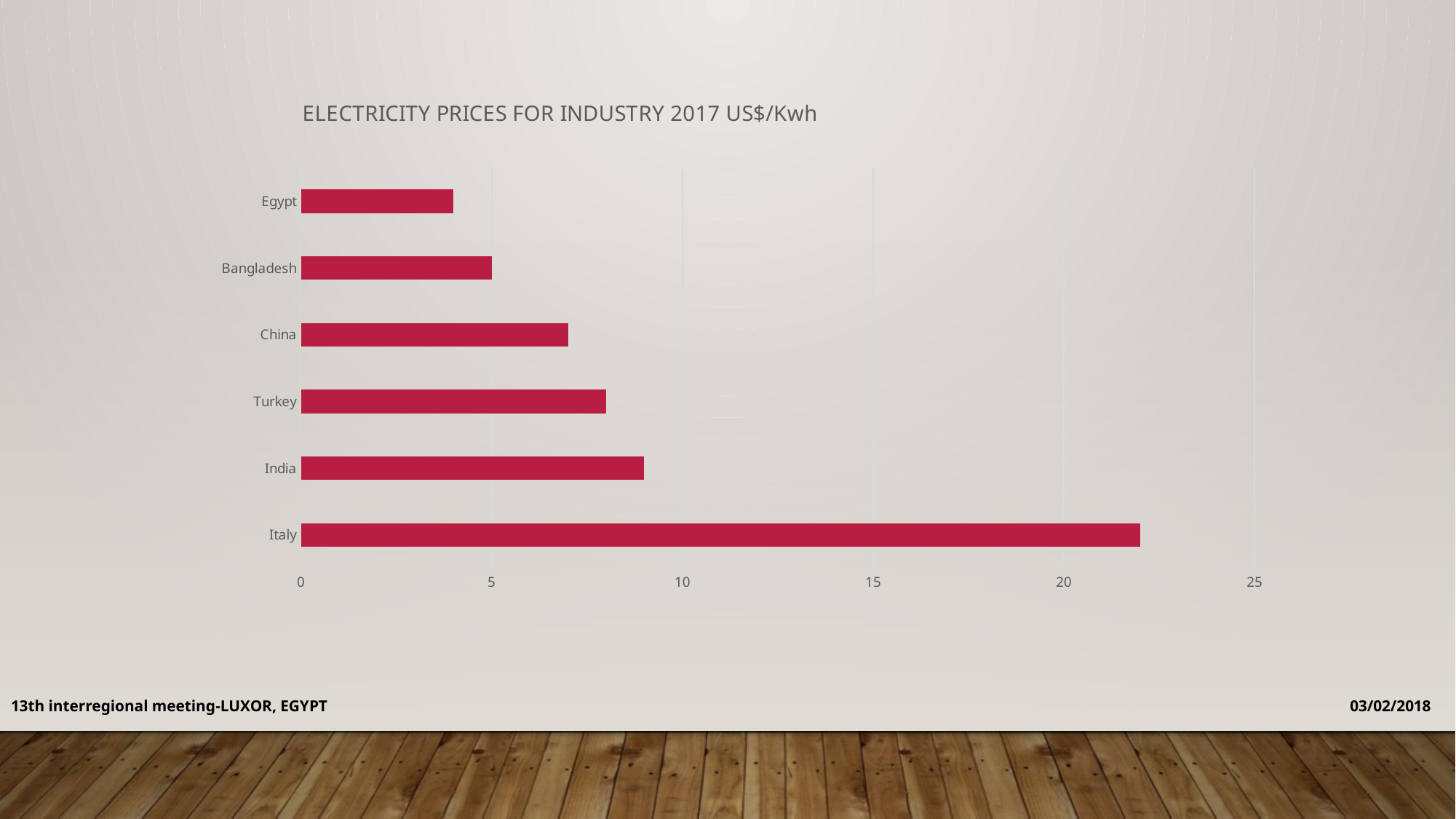
Which has a higher electricity price for industry, Turkey or China? Turkey Is the value for Italy greater or less than 20? greater Which country has the lowest electricity price for industry? Egypt Is the value for Egypt greater or less than 5? less Which country has the highest electricity price for industry? Italy Is the value for China greater or less than 5? greater Which has a higher electricity price for industry, India or Egypt? India What is the electricity price for industry in Bangladesh? 5 How many countries are shown in the chart? 6 What kind of chart is shown on the slide? bar chart What is the title of the chart? ELECTRICITY PRICES FOR INDUSTRY 2017 US$/Kwh